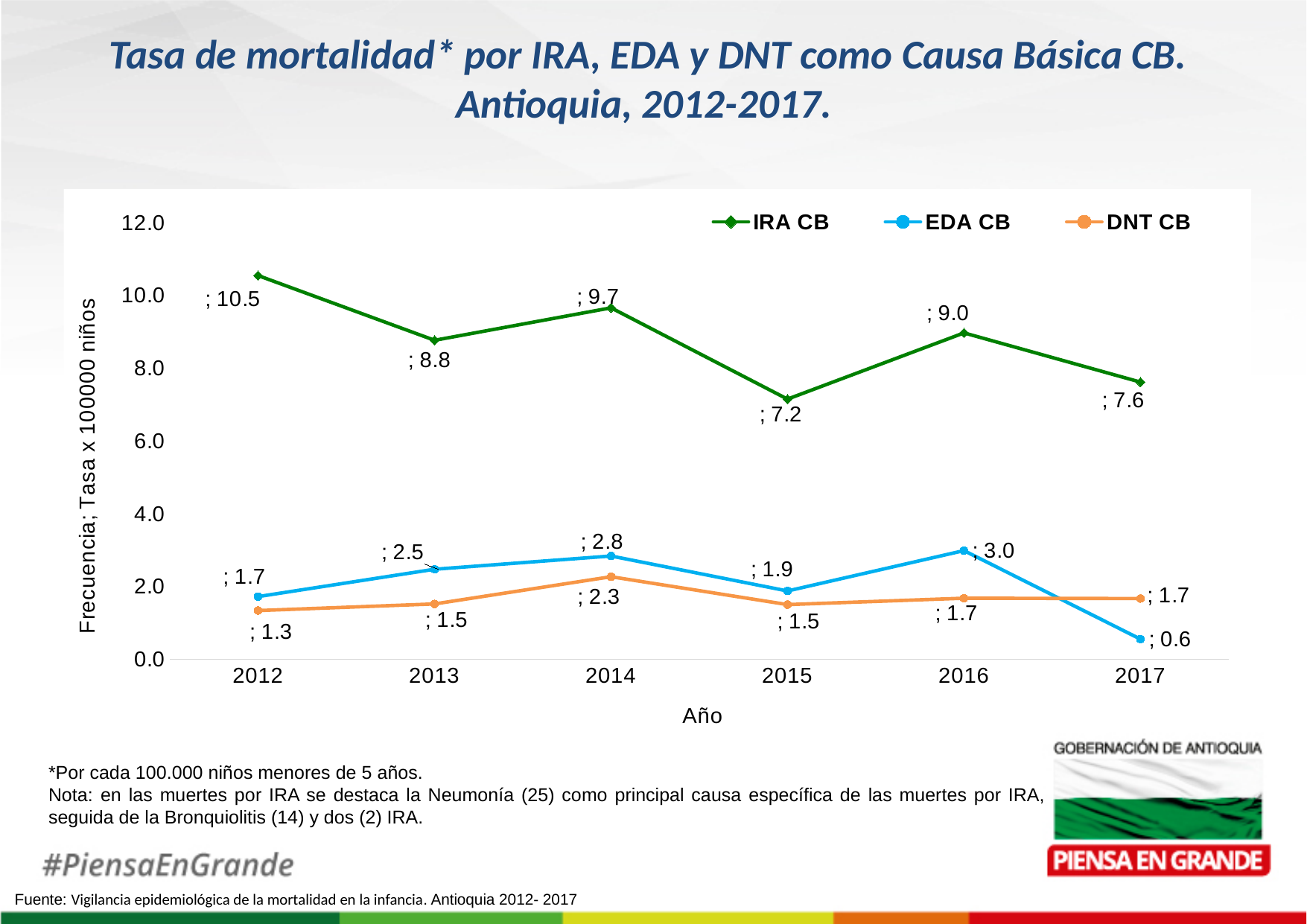
What kind of chart is shown on the slide? Line chart What is the EDA CB mortality rate in 2016? 3.0 How many series does the legend list? 3 How many years are shown on the x axis? 6 In which year is the IRA CB rate lowest? 2015 Does the EDA CB rate rise or fall from 2016 to 2017? Fall What is the label of the y axis? Frecuencia; Tasa x 100000 niños What is the DNT CB mortality rate in 2014? 2.3 What is the IRA CB mortality rate in 2012? 10.5 What is the difference between the IRA CB rate in 2012 and in 2017? 2.9 In which year is the EDA CB rate highest? 2016 Which is larger in 2017, the EDA CB rate or the DNT CB rate? DNT CB